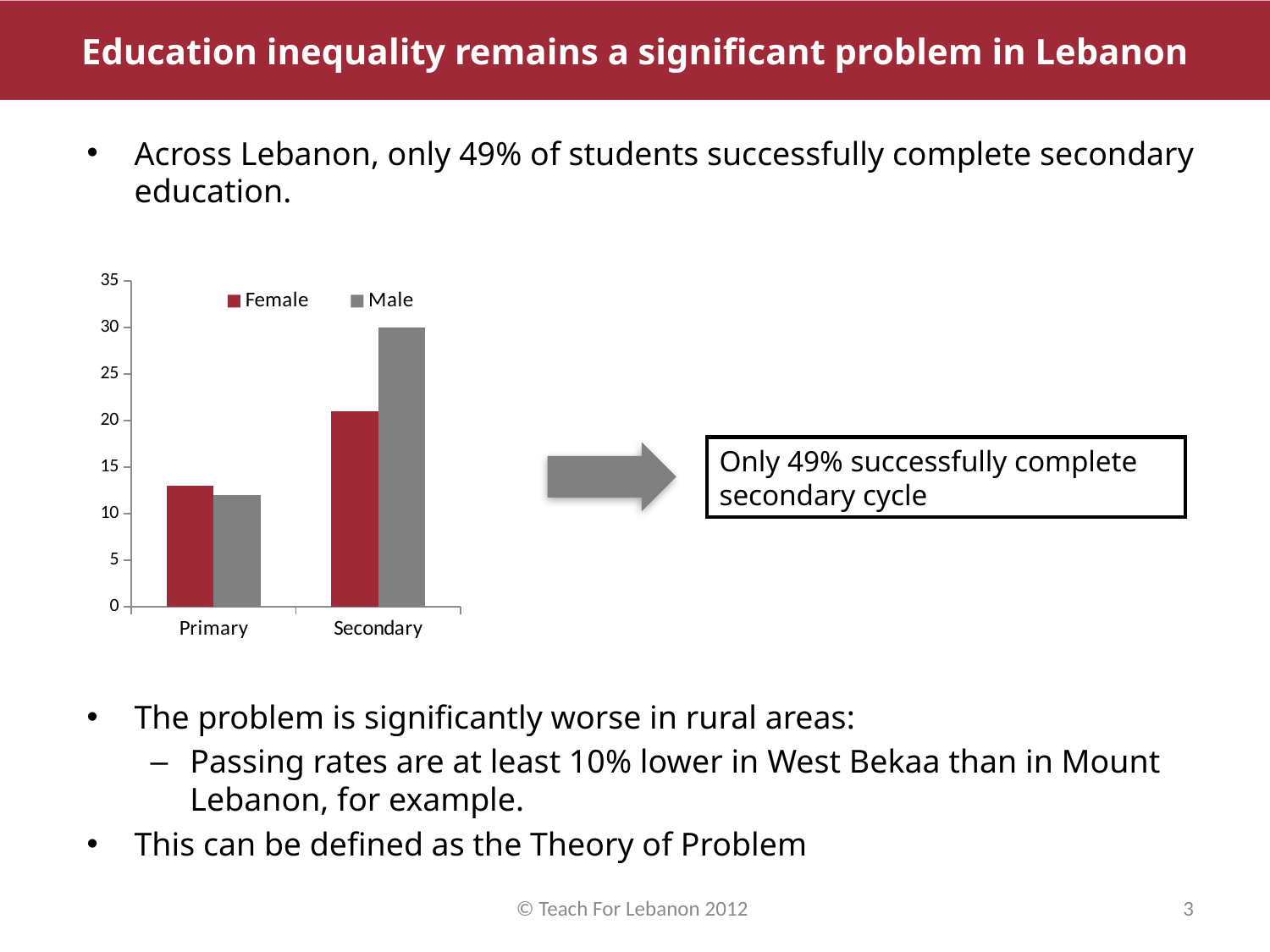
Is the Female value for Secondary greater or less than 15? greater Is the Female value for Secondary greater or less than 25? less What is the Male value for Secondary? 30 Is the Female value for Primary greater or less than 15? less Do the Male values rise or fall from Primary to Secondary? rise Which colour represents the Male series in the chart? Grey How many series does the chart's legend list? 2 What kind of chart is shown on the slide? Bar chart For Secondary, which is larger, the Female value or the Male value? Male How many categories are shown on the x axis of the chart? 2 Which bar is the highest in the chart? Male, Secondary